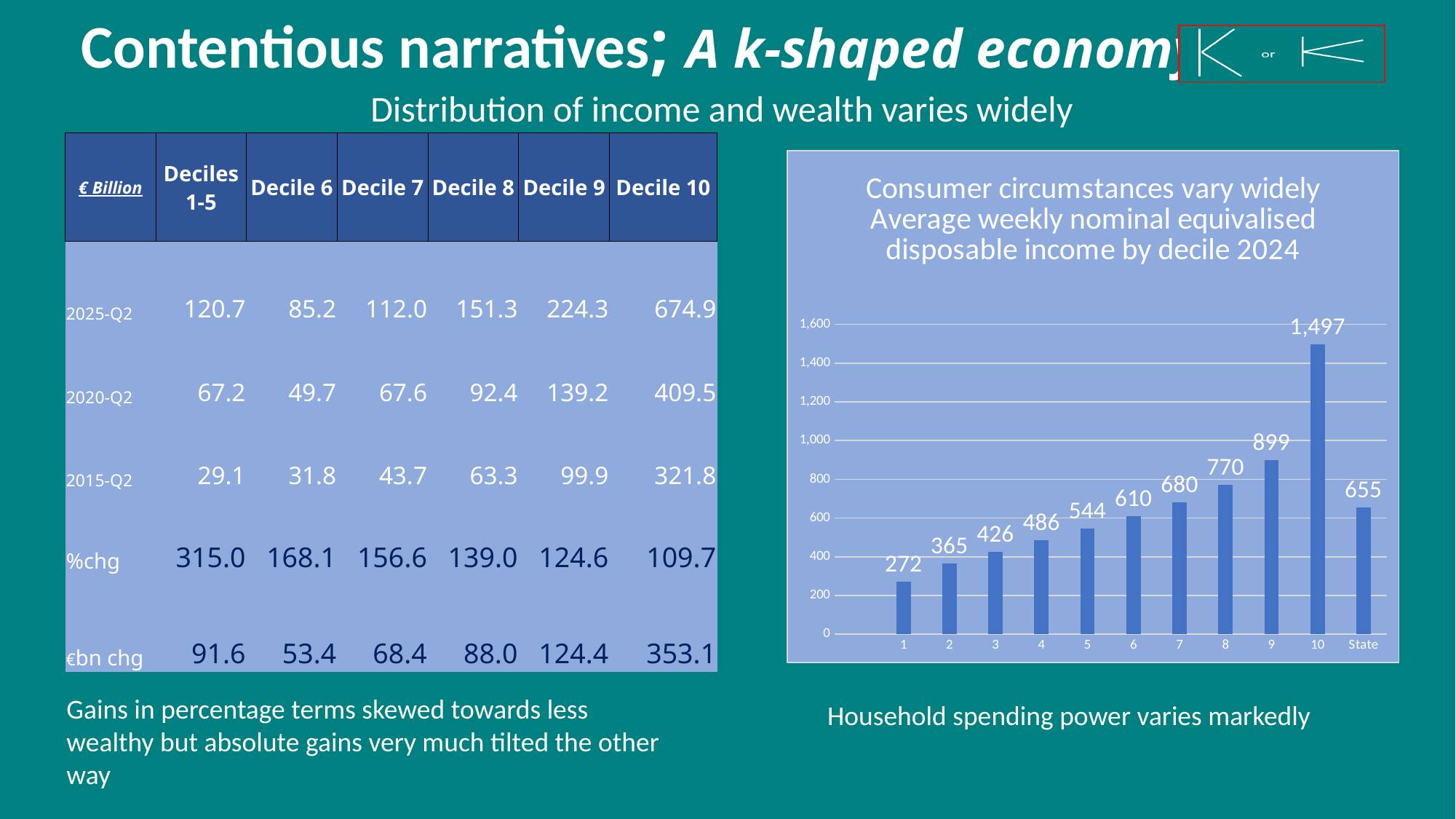
What is the value for decile 1 in the bar chart? 272 What is the difference between the values for decile 9 and decile 1 in the bar chart? 627 What is the difference between the values for decile 10 and decile 9 in the bar chart? 598 What is the value for decile 10 in the bar chart? 1,497 How many bars are plotted in the bar chart? 11 Do the values rise or fall from decile 1 to decile 10 in the bar chart? rise Which category has the lowest value in the bar chart? 1 What kind of chart is shown on the right of the slide? bar chart What is the value for the State category in the bar chart? 655 Which category has the highest value in the bar chart? 10 Which is larger in the bar chart: the value for decile 7 or the value for State? decile 7 What is the value for decile 5 in the bar chart? 544